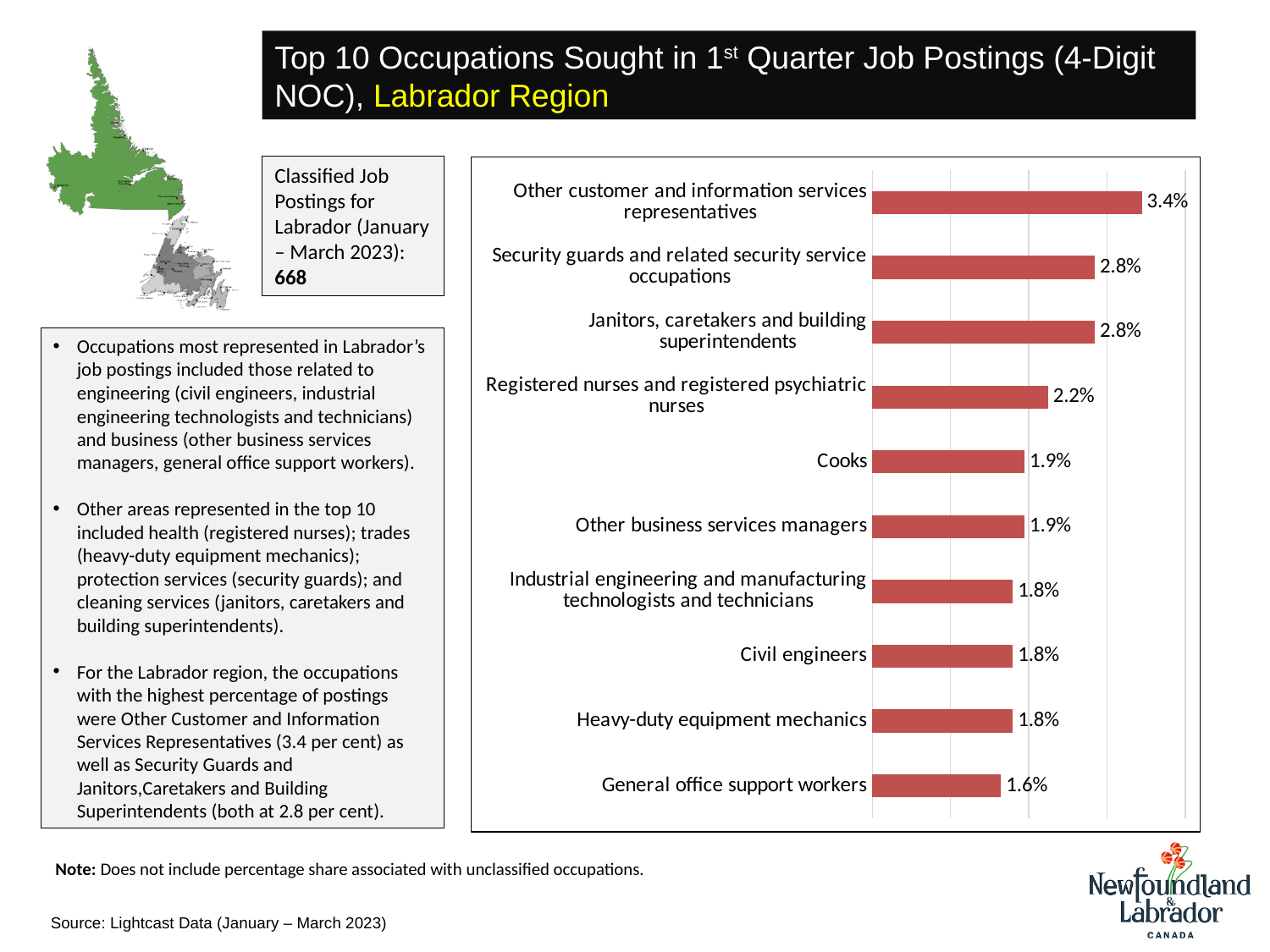
Which occupation has the lowest value? General office support workers Which occupation has the highest value? Other customer and information services representatives What is the value for General office support workers? 1.6% How many occupations are shown in the chart? 10 What is the value for Cooks? 1.9% Which is larger, the value for Registered nurses and registered psychiatric nurses or the value for Civil engineers? Registered nurses and registered psychiatric nurses What is the value for Heavy-duty equipment mechanics? 1.8% What is the difference between the values for Other customer and information services representatives and General office support workers? 1.8% What is the value for Security guards and related security service occupations? 2.8% What is the difference between the values for Security guards and related security service occupations and Cooks? 0.9% What is the value for Registered nurses and registered psychiatric nurses? 2.2% What kind of chart is shown on the slide? Bar chart